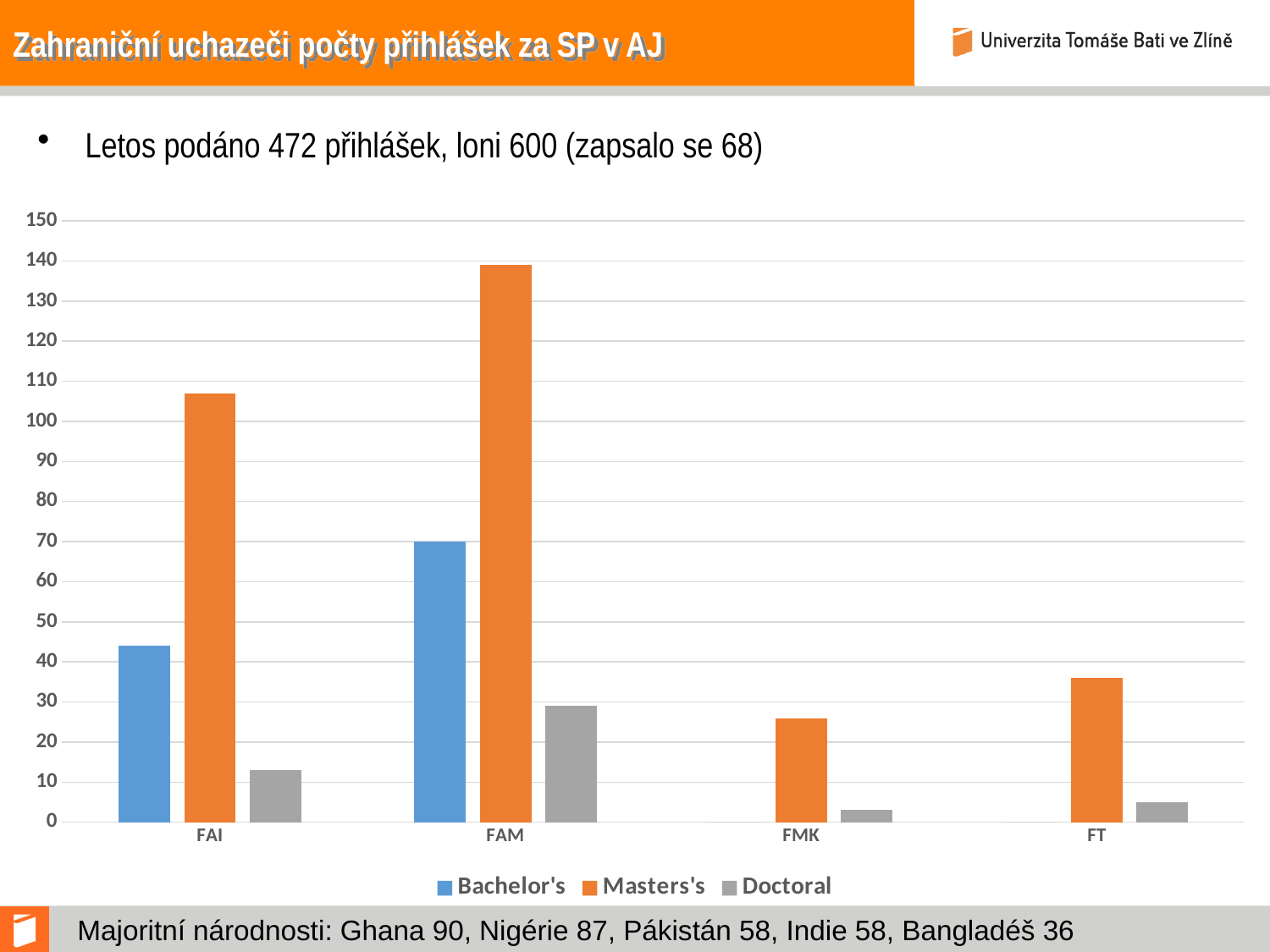
How many series does the legend list? 3 Is the Masters's value for FAM greater or less than 130? greater Is the Masters's value for FT greater or less than 40? less What is the Bachelor's value for FAM? 70 Is the Masters's value for FAI greater or less than 100? greater Which faculty has the lowest Doctoral value? FMK Which colour represents the Doctoral series in the chart? grey How many faculty categories are shown on the x axis? 4 Which faculty has the highest Masters's value? FAM What kind of chart is shown on the slide? bar chart Which is larger, the Bachelor's value for FAI or the Bachelor's value for FAM? FAM